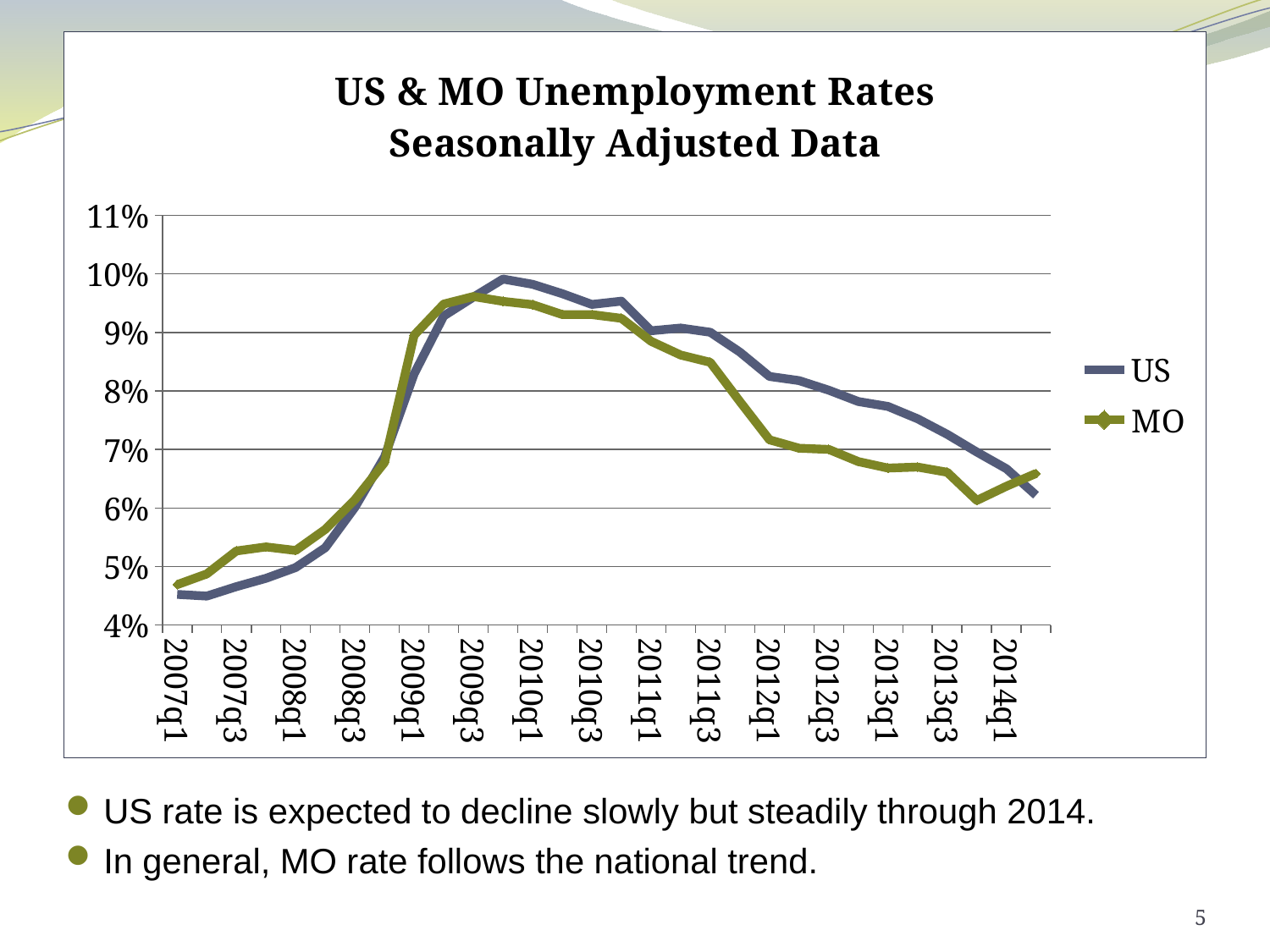
At 2008q1, which series has the higher unemployment rate, US or MO? MO How many series does the legend list? 2 Does the US unemployment rate rise or fall from 2010q1 to 2014q1? fall Is the US unemployment rate at 2007q1 greater or less than 5%? less Is the MO unemployment rate at 2012q1 greater or less than 7%? greater What are the two series named in the legend? US and MO What kind of chart is shown on the slide? line chart Is the MO unemployment rate at 2013q3 greater or less than 7%? less At 2012q1, which series has the higher unemployment rate, US or MO? US Which series reaches the highest unemployment rate on the chart? US What is the title of the chart? US & MO Unemployment Rates Seasonally Adjusted Data